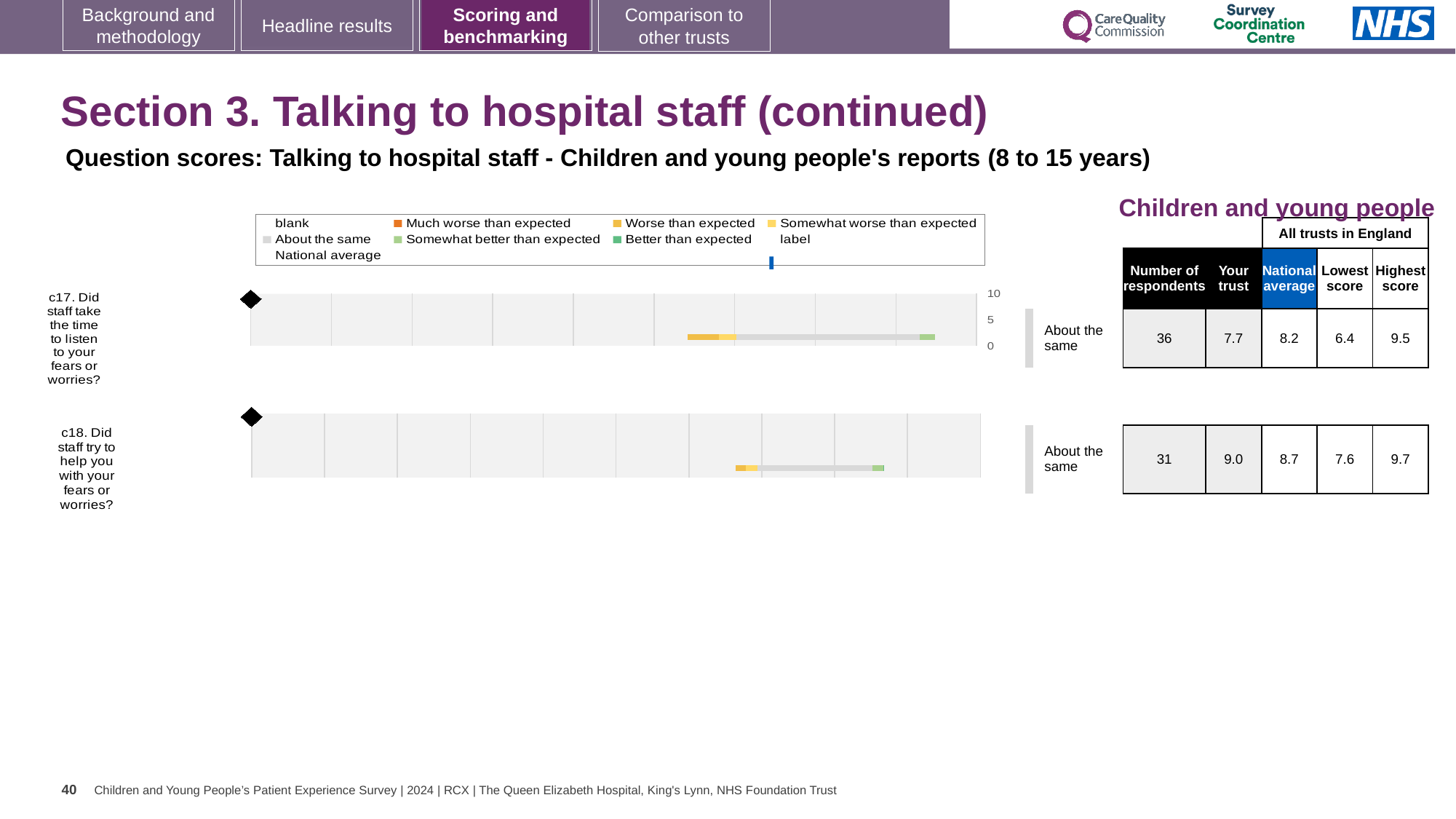
What is the maximum value shown on the chart's score axis? 10 What kind of chart is used to show the question scores for c17 and c18? Bar chart What is the difference between the highest score and the lowest score for c17? 3.1 For c17, which is larger: the trust's score or the national average? National average What is the 'Your trust' score for c17 (Did staff take the time to listen to your fears or worries?)? 7.7 Which question has the higher 'Your trust' score, c17 or c18? c18 For c18, which is larger: the trust's score or the national average? Your trust What is the difference between the highest score and the lowest score for c18? 2.1 How many respondents answered question c17? 36 What benchmark category is shown for c17? About the same How many survey questions are plotted on the slide? 2 What is the national average score for c18 (Did staff try to help you with your fears or worries?)? 8.7